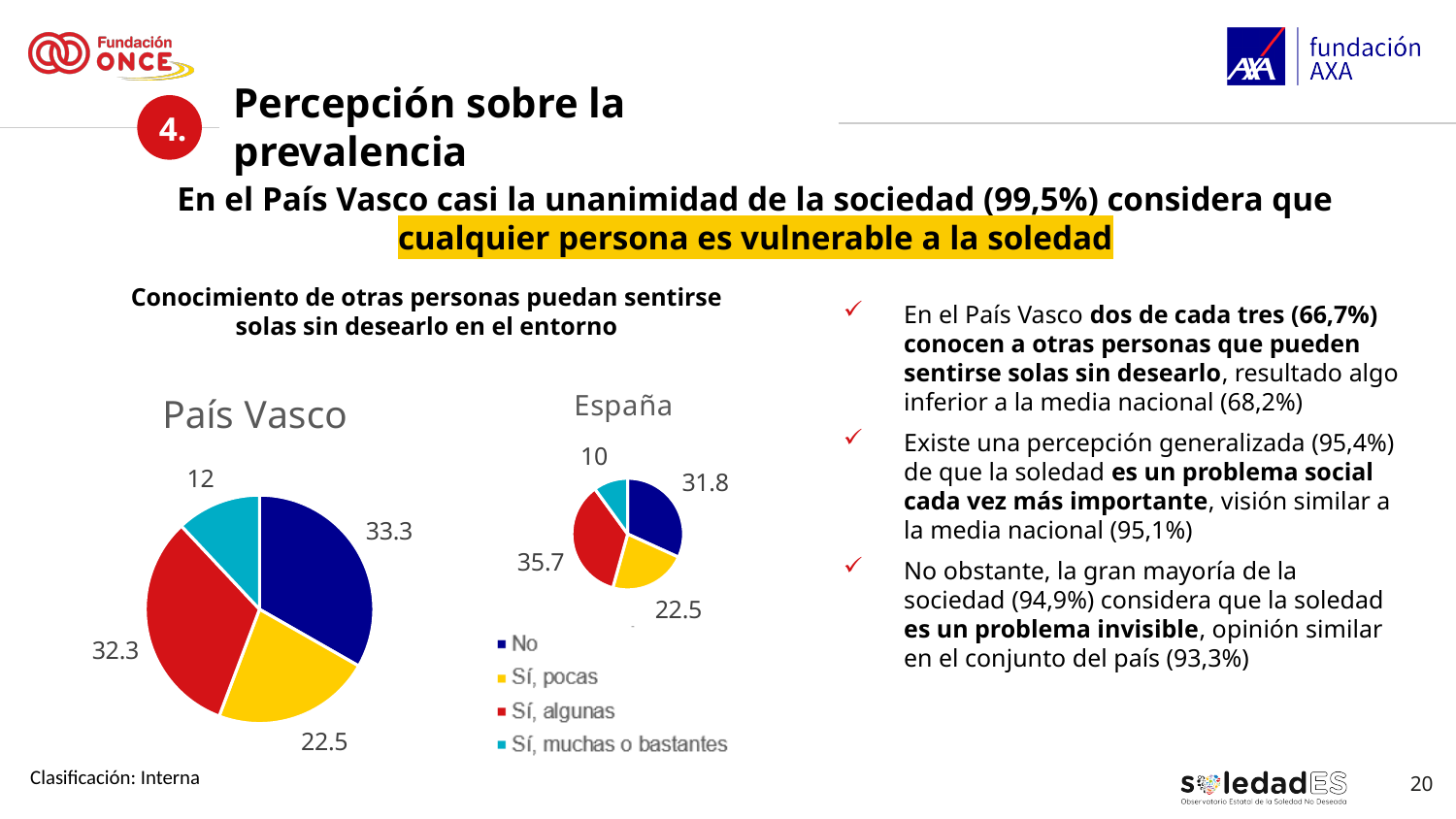
What type of chart is used to show the País Vasco data? Pie chart What is the difference between the "Sí, algunas" value in the España chart and the "Sí, algunas" value in the País Vasco chart? 3.4 In the España pie chart, what is the value for "Sí, pocas"? 22.5 In the España pie chart, what is the value for "Sí, algunas"? 35.7 In the España pie chart, which category has the smallest slice? Sí, muchas o bastantes Which is larger: the "No" value in the País Vasco chart or the "No" value in the España chart? País Vasco How many categories does the legend list for the pie charts? 4 In the legend, which colour represents "Sí, pocas"? Yellow In the País Vasco pie chart, what is the value for "Sí, muchas o bastantes"? 12 In the País Vasco pie chart, what is the value for "No"? 33.3 In the País Vasco pie chart, which category has the largest slice? No In the España pie chart, which category has the largest slice? Sí, algunas